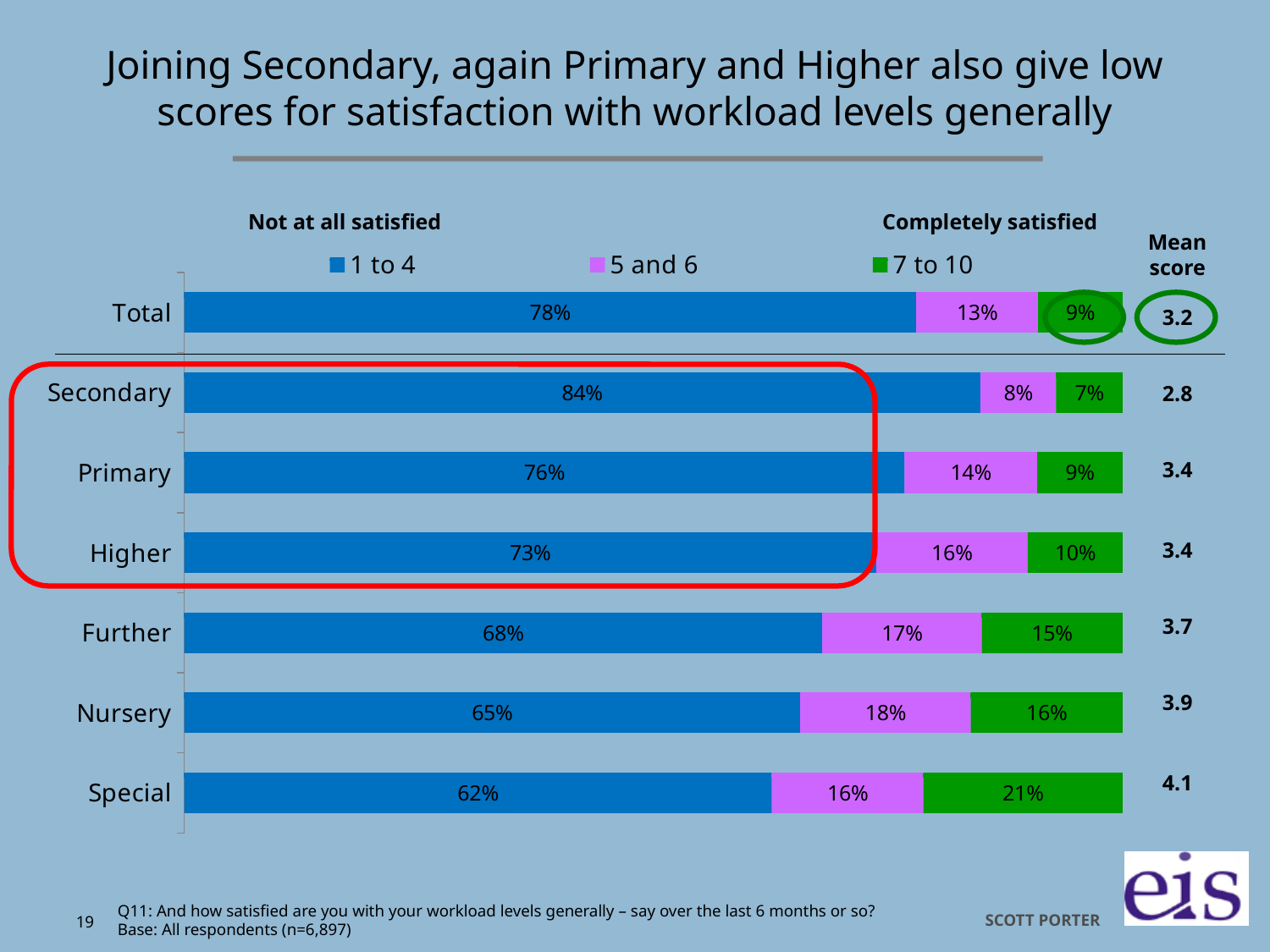
Which is larger: the 5 and 6 percentage for Nursery or for Primary? Nursery Which category has the highest mean score? Special Which category has the lowest percentage in the 7 to 10 band? Secondary What is the total of the three segments for the Further bar? 100% What is the difference between the 1 to 4 percentages for Secondary and Special? 22% Which category has the highest percentage in the 1 to 4 band? Secondary How many categories (rows) are shown in the chart, including Total? 7 What percentage of Special respondents gave a score of 7 to 10? 21% What is the mean score for Nursery? 3.9 What kind of chart is shown on the slide? Stacked bar chart What percentage of Secondary respondents gave a score of 1 to 4? 84% How many series does the legend list? 3